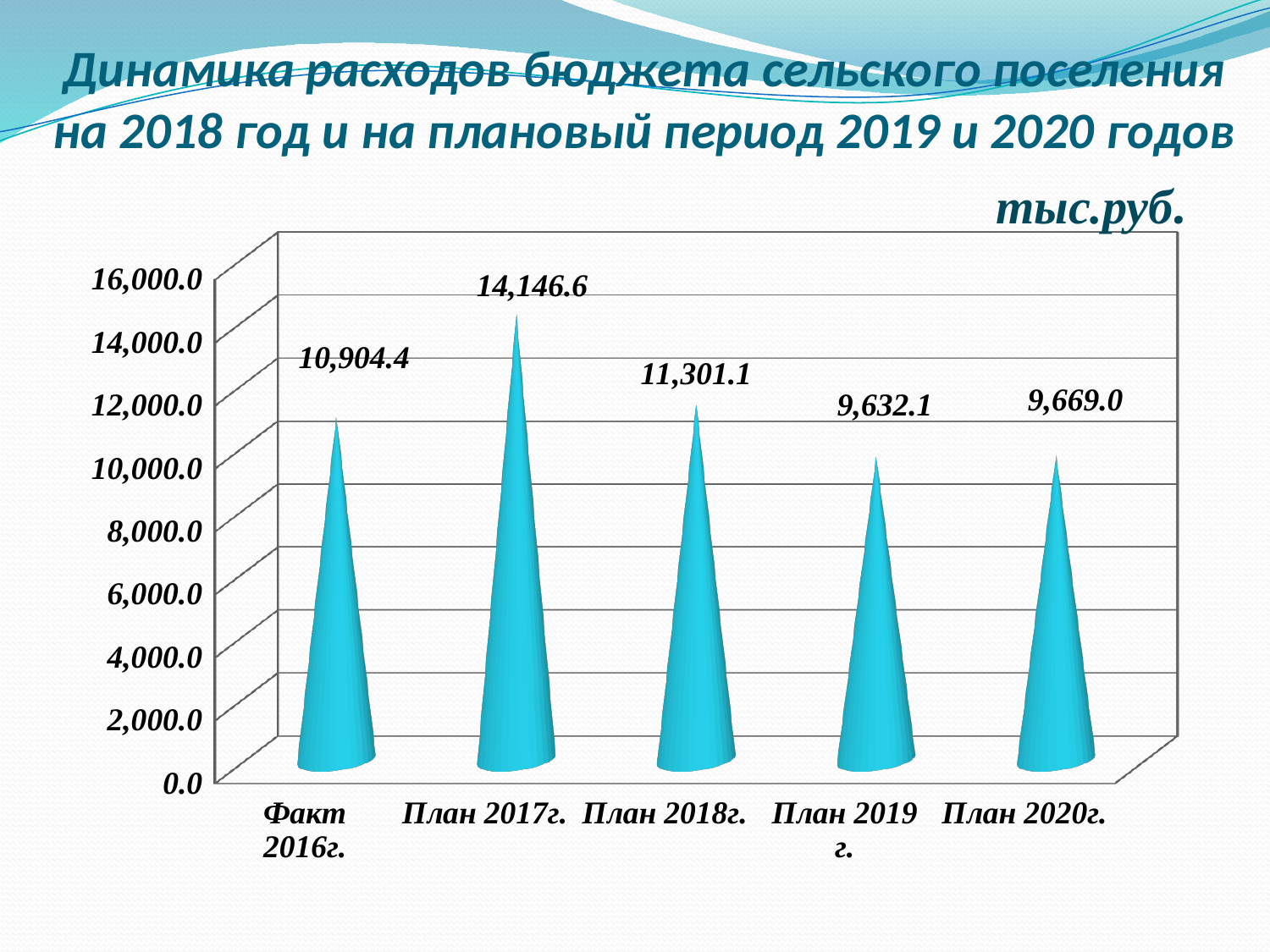
What kind of chart is shown on the slide? bar chart How many categories are shown on the x axis? 5 Which is larger, the value for План 2018г. or the value for План 2020г.? План 2018г. Which category has the highest value? План 2017г. Is the value for План 2018г. greater or less than 12,000.0? less What is the value for Факт 2016г.? 10,904.4 What unit of measurement is indicated above the chart? тыс.руб. What is the difference between the values for План 2017г. and Факт 2016г.? 3,242.2 What is the value for План 2017г.? 14,146.6 Which category has the lowest value? План 2019 г. What is the difference between the values for План 2020г. and План 2019 г.? 36.9 What is the value for План 2019 г.? 9,632.1